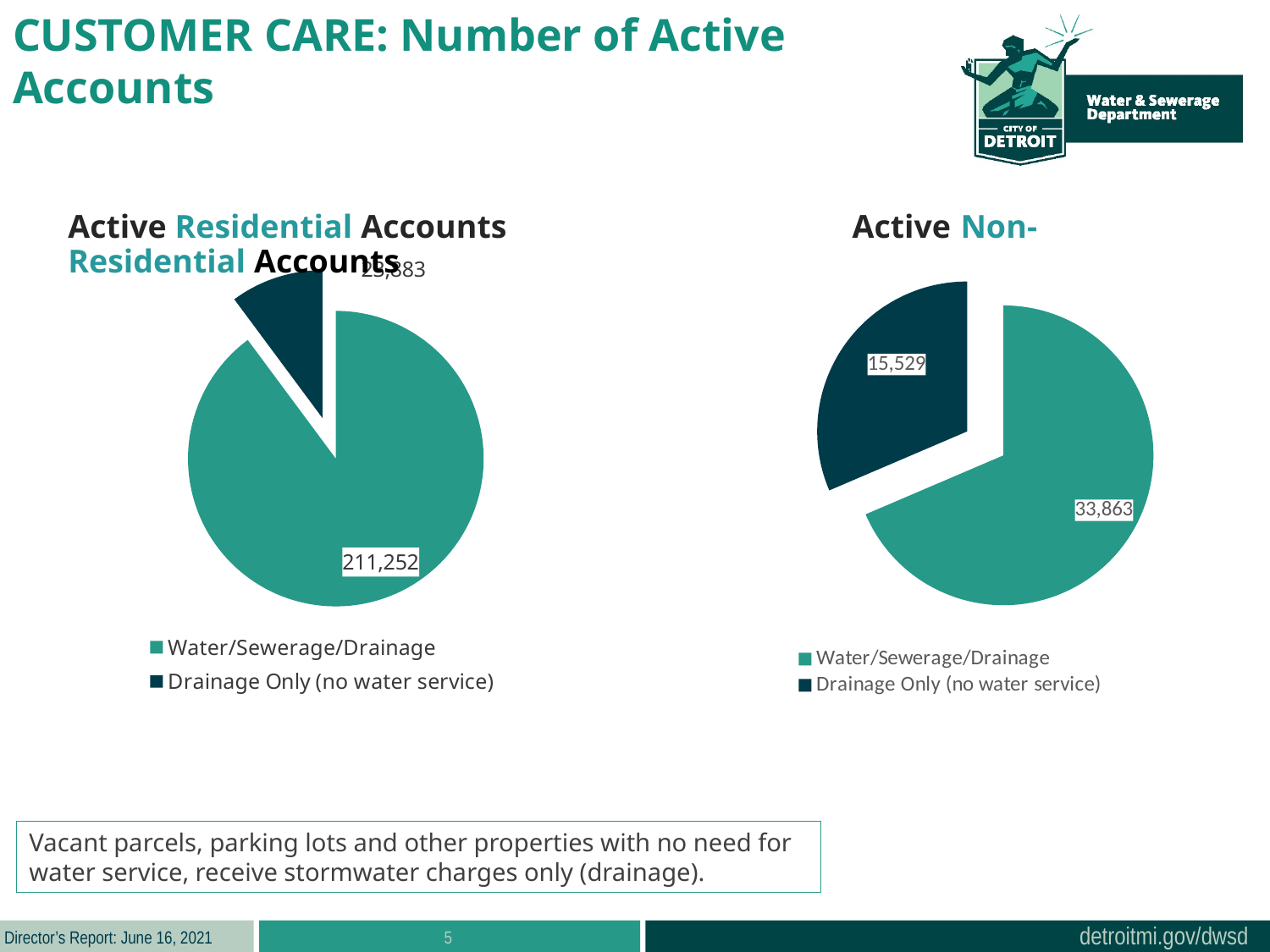
How many entries does the legend of the Active Residential Accounts chart list? 2 In the Active Residential Accounts chart, is the Water/Sewerage/Drainage slice larger or smaller than the Drainage Only slice? larger How many slices does the Active Non-Residential Accounts pie chart have? 2 What type of chart is used for the Active Residential Accounts? pie chart In the Active Non-Residential Accounts chart, how many Drainage Only (no water service) accounts are there? 15,529 In the Active Non-Residential Accounts chart, which colour represents Drainage Only (no water service)? dark teal (dark blue-green) In the Active Residential Accounts chart, which category has the smaller slice? Drainage Only (no water service) In the Active Non-Residential Accounts chart, how many Water/Sewerage/Drainage accounts are there? 33,863 In the Active Non-Residential Accounts chart, which category has the larger slice? Water/Sewerage/Drainage In the Active Non-Residential Accounts chart, what is the total number of accounts across both slices? 49,392 In the Active Non-Residential Accounts chart, what is the difference between the Water/Sewerage/Drainage and Drainage Only (no water service) values? 18,334 In the Active Residential Accounts chart, how many Water/Sewerage/Drainage accounts are there? 211,252